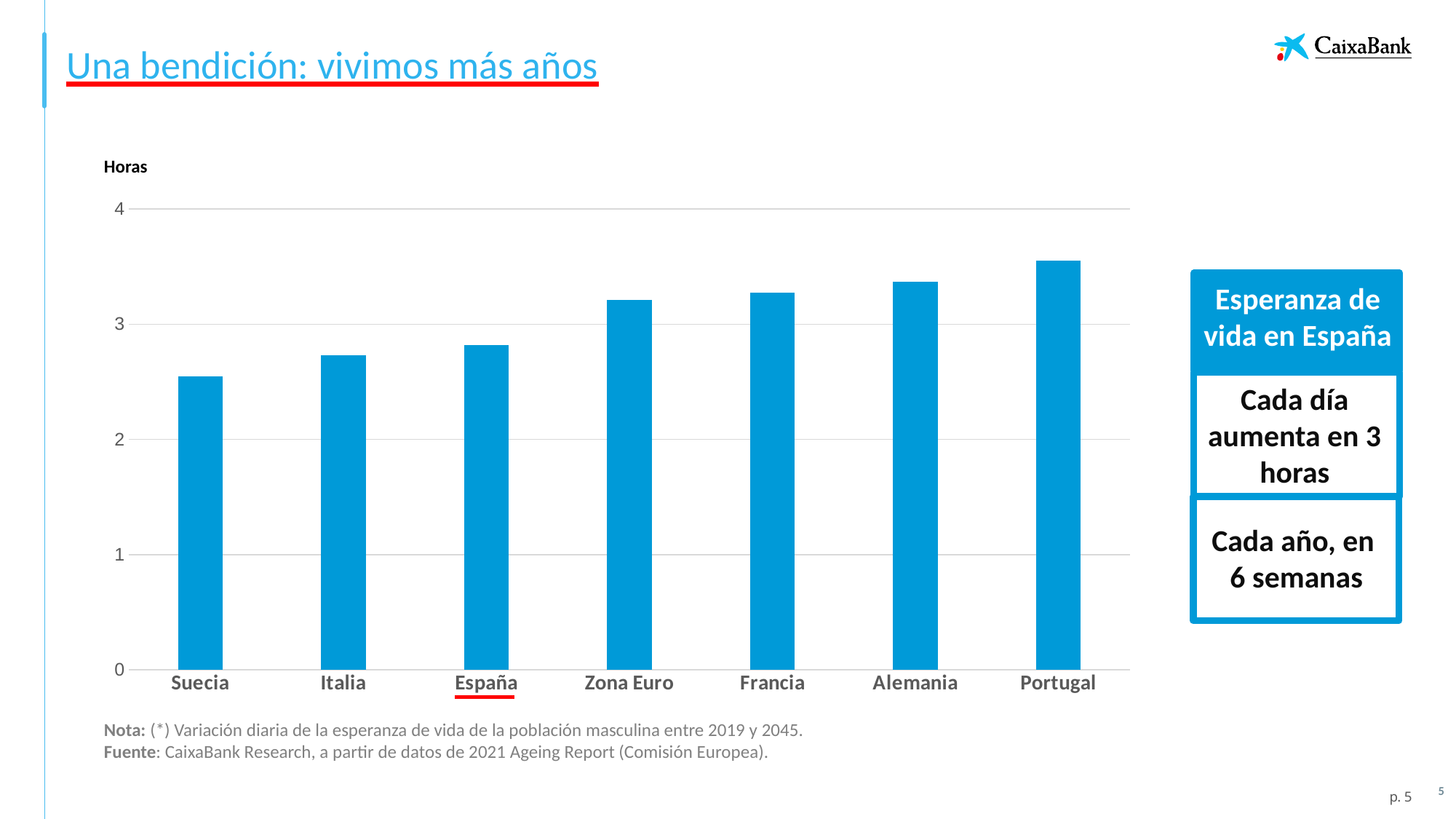
Is the value for Zona Euro greater or less than 3? greater Is the value for España greater or less than 3? less Is the value for Portugal greater or less than 3? greater Which has a larger value, Portugal or Suecia? Portugal Which category has the lowest bar in the chart? Suecia What unit label is shown above the vertical axis of the chart? Horas What kind of chart is shown on the slide? bar chart How many categories (countries/regions) are shown on the x axis of the chart? 7 Which category has the highest bar in the chart? Portugal Which has a larger value, Zona Euro or España? Zona Euro Do the bar values rise or fall moving from left to right along the x axis? rise